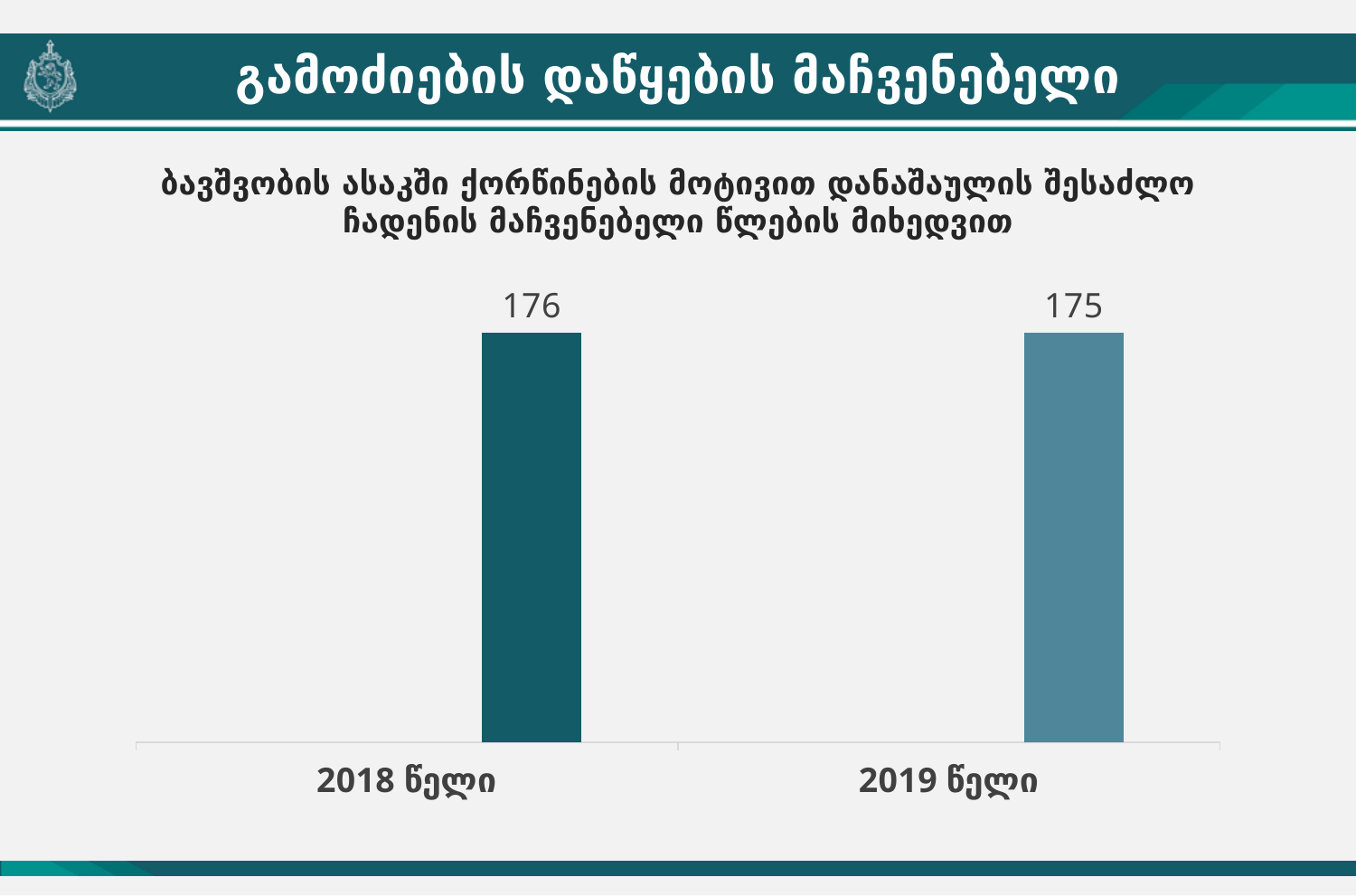
How many categories are shown on the x axis? 2 What is the label of the first category on the x axis? 2018 წელი What is the difference between the values for 2018 წელი and 2019 წელი? 1 What kind of chart is shown on the slide? bar chart Are the two bars the same colour? No What is the total of the values for 2018 წელი and 2019 წელი? 351 Is the value for 2018 წელი larger or smaller than the value for 2019 წელი? larger Which year has the higher value? 2018 წელი Do the values rise or fall from 2018 წელი to 2019 წელი? fall What is the value for 2019 წელი? 175 Which year has the lower value? 2019 წელი What is the value for 2018 წელი? 176